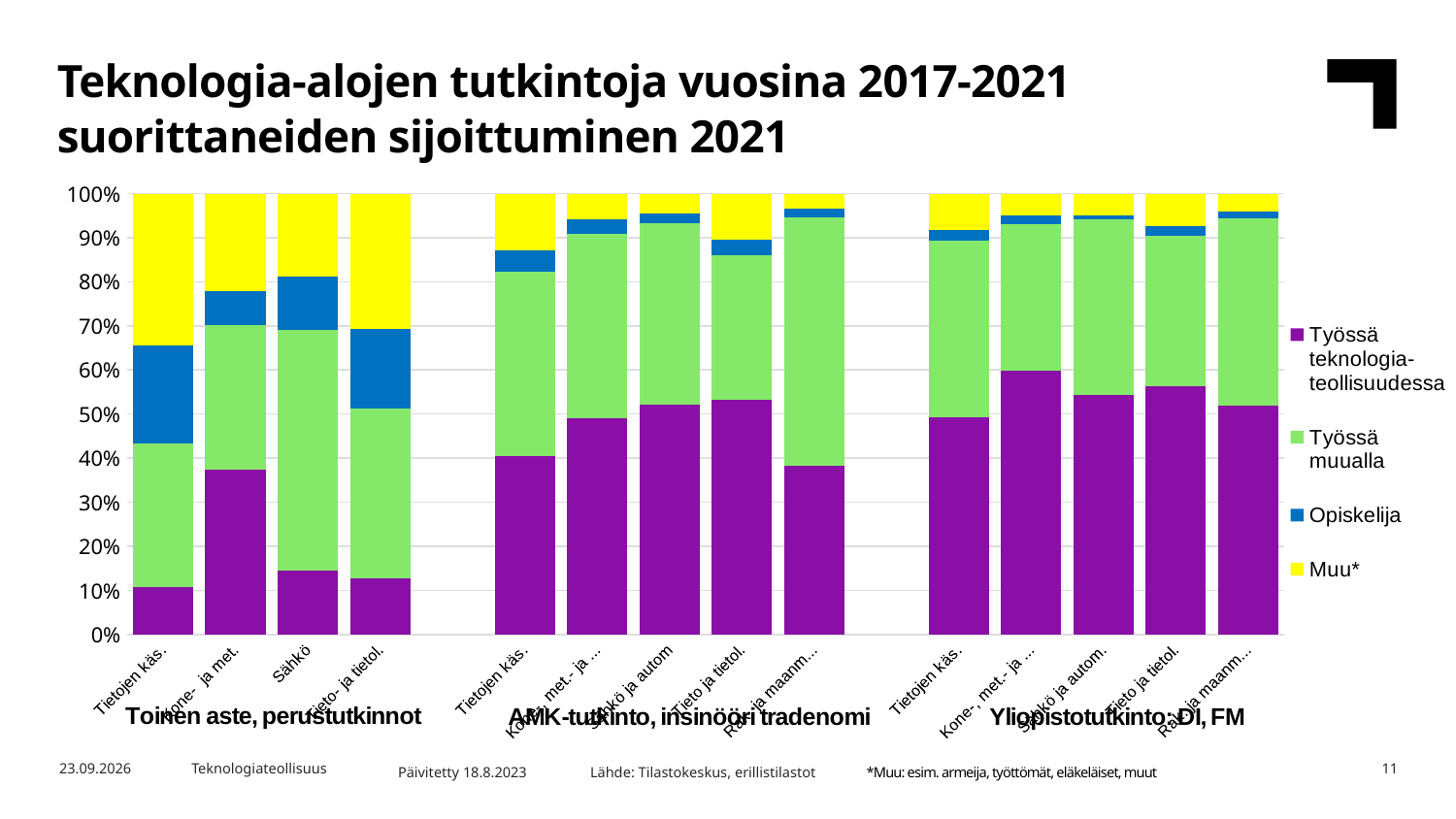
How many bars are in the 'AMK-tutkinto, insinööri tradenomi' group? 5 How many bars are plotted in the chart in total? 14 In the 'Toinen aste, perustutkinnot' group, is the 'Työssä teknologiateollisuudessa' share for 'Tietojen käs.' greater or less than 20%? less How many bars are in the 'Toinen aste, perustutkinnot' group? 4 What are the three education-level groups labelled along the x axis? Toinen aste, perustutkinnot; AMK-tutkinto, insinööri tradenomi; Yliopistotutkinto: DI, FM Which legend entry is shown in yellow? Muu* In the 'AMK-tutkinto, insinööri tradenomi' group, is the 'Työssä teknologiateollisuudessa' share for 'Tietojen käs.' greater or less than 50%? less In the 'Yliopistotutkinto: DI, FM' group, is the 'Työssä teknologiateollisuudessa' share for the second bar (Kone-, met.- ja ...) greater or less than 50%? greater In the 'Toinen aste, perustutkinnot' group, which category has the largest 'Työssä teknologiateollisuudessa' share? Kone- ja met. What kind of chart is shown on the slide? Stacked bar chart How many series does the legend list? 4 In the 'Toinen aste, perustutkinnot' group, which has the larger 'Työssä teknologiateollisuudessa' share: 'Tietojen käs.' or 'Kone- ja met.'? Kone- ja met.